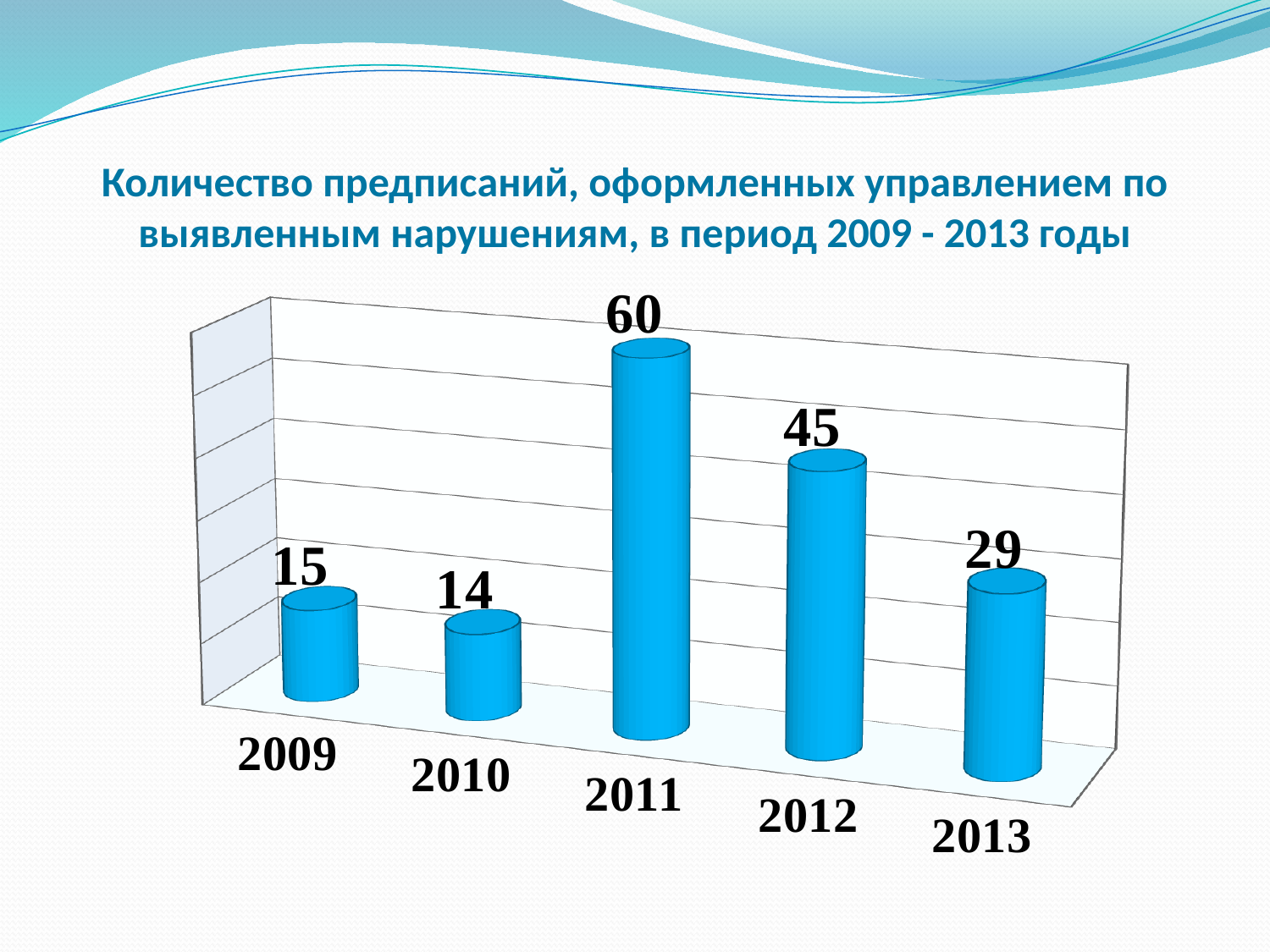
Which year has the highest value? 2011 What is the value for 2013? 29 What is the title of the chart? Количество предписаний, оформленных управлением по выявленным нарушениям, в период 2009 - 2013 годы What is the value for 2009? 15 Which is larger, the value for 2012 or the value for 2013? 2012 What is the value for 2011? 60 How many years are shown on the chart? 5 What is the difference between the values for 2011 and 2012? 15 Which year has the lowest value? 2010 What is the difference between the values for 2013 and 2010? 15 What kind of chart is shown on the slide? bar chart Do the values rise or fall from 2011 to 2013? fall